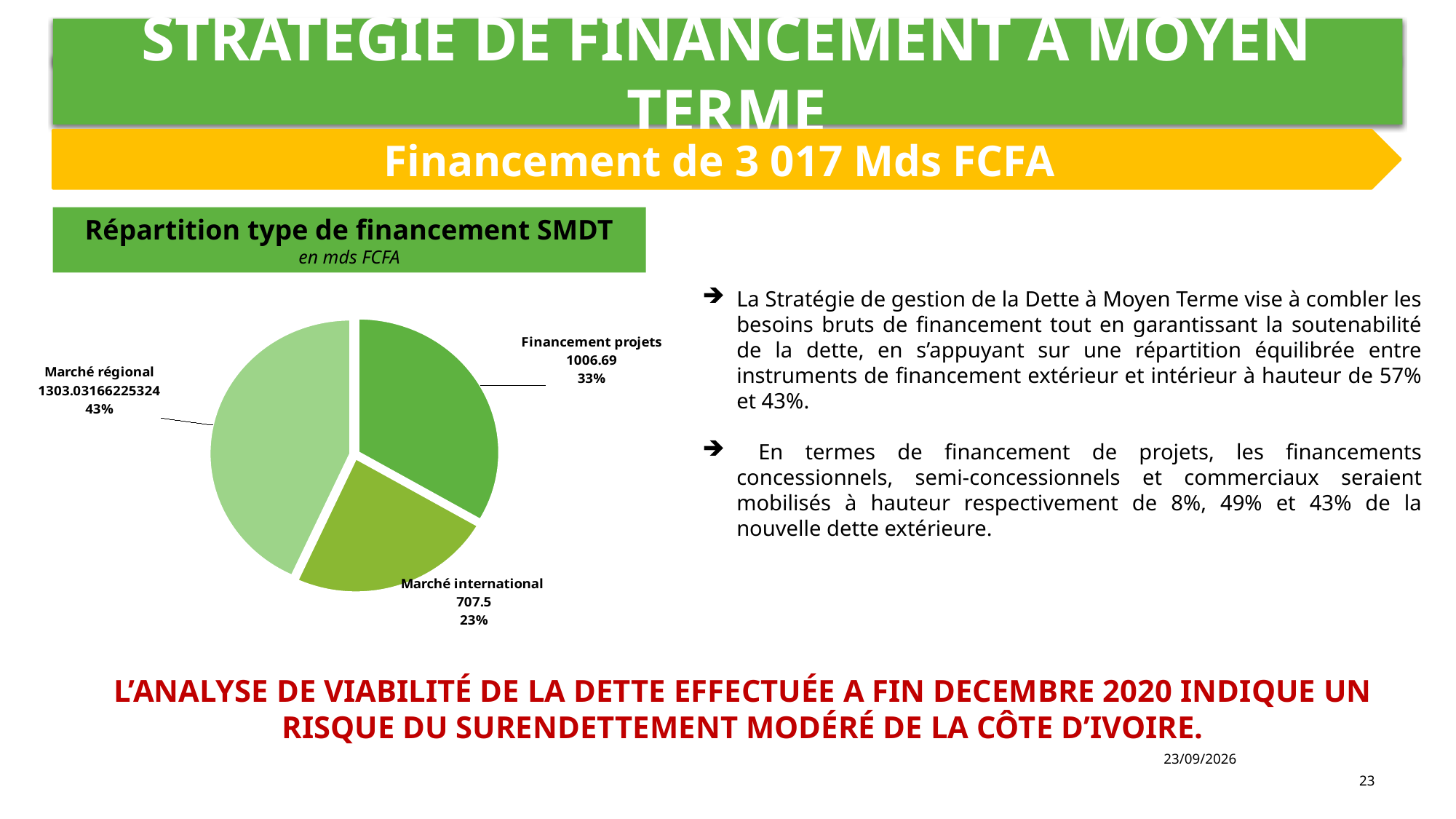
What is the value for Financement projets in the pie chart? 1006.69 What is the value for Marché international in the pie chart? 707.5 Which category has the largest slice in the pie chart? Marché régional What share of the pie does Financement projets represent? 33% What share of the pie does Marché international represent? 23% What type of chart is shown on the slide? pie chart What is the value for Marché régional in the pie chart? 1303.03166225324 How many slices does the pie chart have? 3 What share of the pie does Marché régional represent? 43% Which is larger in the pie chart, Financement projets or Marché international? Financement projets Which category has the smallest slice in the pie chart? Marché international What is the title of the pie chart? Répartition type de financement SMDT